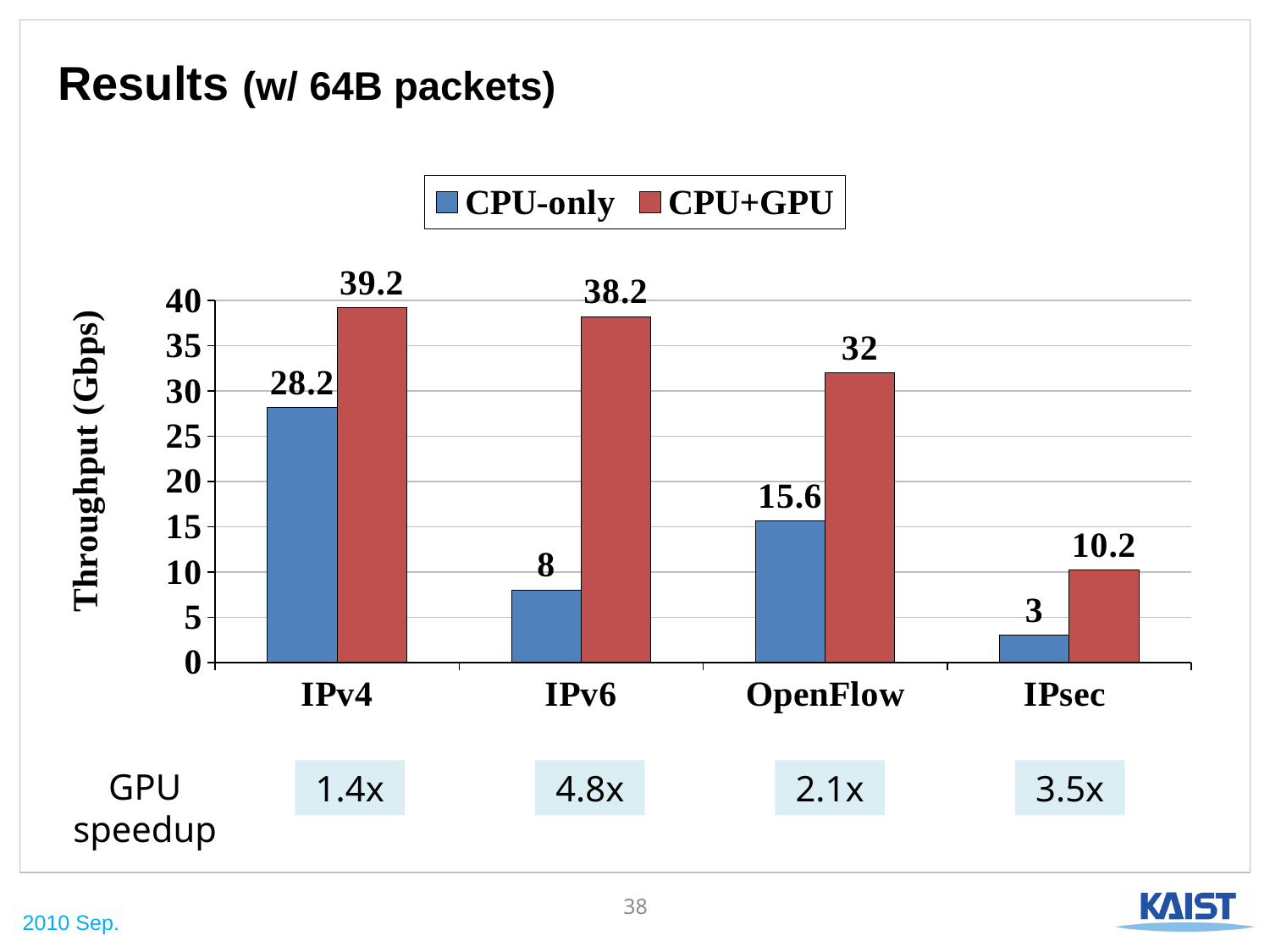
Is the CPU+GPU throughput for IPv6 greater or less than 35? greater What kind of chart is shown on the slide? bar chart What is the CPU-only throughput for OpenFlow? 15.6 Which is larger, the CPU-only throughput for IPv4 or the CPU+GPU throughput for OpenFlow? CPU+GPU throughput for OpenFlow How many categories are shown on the x axis? 4 What is the label of the y axis? Throughput (Gbps) Which category has the lowest CPU-only throughput? IPsec What is the CPU-only throughput for IPv4? 28.2 How many series does the legend list? 2 What is the CPU+GPU throughput for IPsec? 10.2 Which category has the highest CPU+GPU throughput? IPv4 What is the difference between the CPU+GPU and CPU-only throughput for IPv6? 30.2